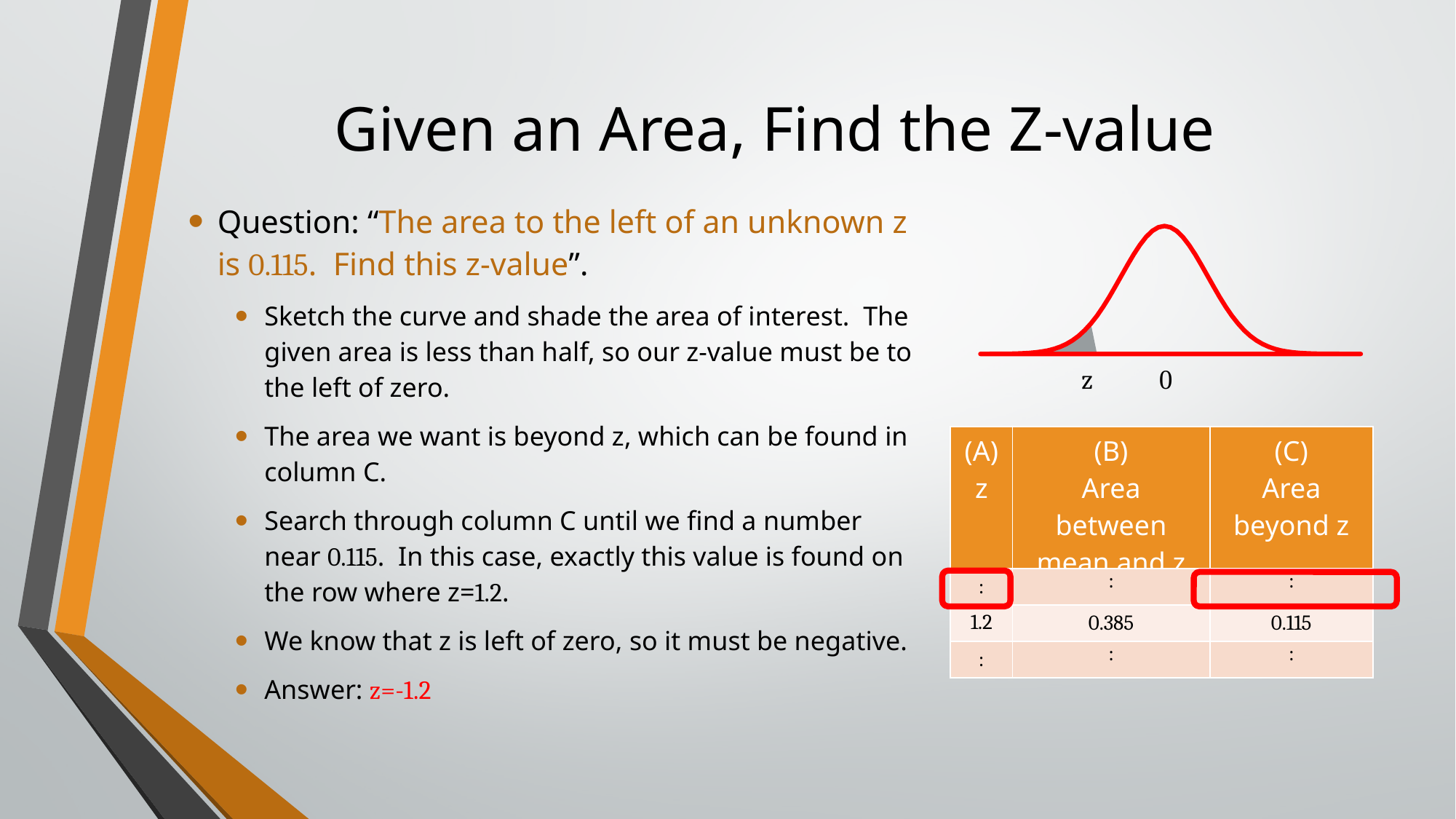
What colour is the curve drawn in the top-right diagram? Red On the curve in the top right, is the shaded area to the left or to the right of 0? To the left What kind of chart is shown in the top right of the slide? An area chart (a bell-shaped normal curve with a shaded tail) How many columns does the table below the curve have? 3 In the table below the curve, what is the value in column (C) 'Area beyond z' for the row where z = 1.2? 0.115 In the table below the curve, what is the value in column (B) 'Area between mean and z' for the row where z = 1.2? 0.385 What two labels appear beneath the horizontal axis of the curve in the top right? z and 0 In the table below the curve, what is the difference between the column (B) value and the column (C) value for z = 1.2? 0.270 In the table below the curve, which is larger for z = 1.2: the area between mean and z, or the area beyond z? Area between mean and z